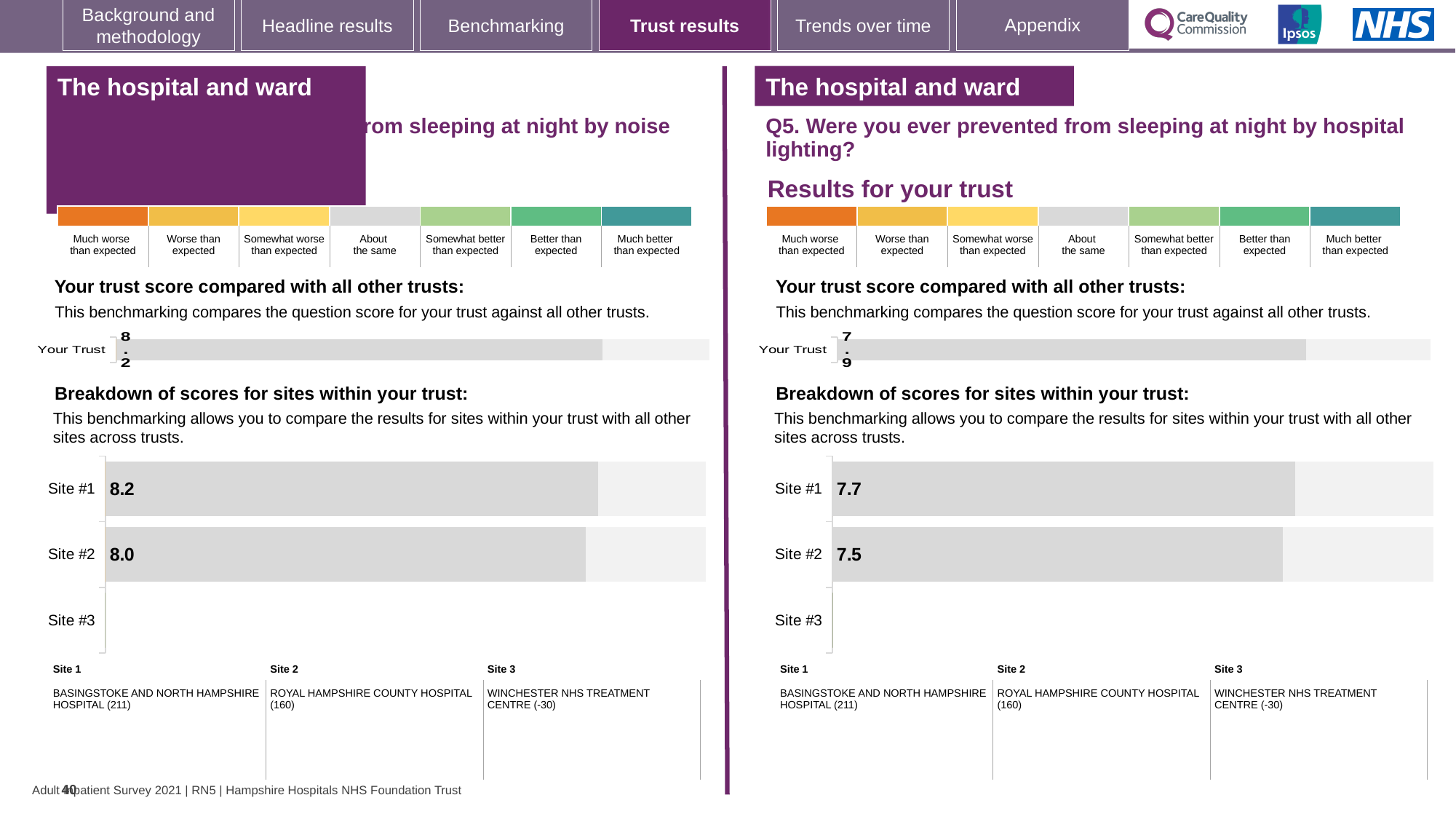
In the left-hand site breakdown chart (sleeping at night by noise), what is the score for Site #2? 8.0 How many site categories are listed on the axis of the left-hand site breakdown chart? 3 In the right-hand site breakdown chart for Q5 (hospital lighting), what is the score for Site #2? 7.5 In the left-hand site breakdown chart (sleeping at night by noise), what is the score for Site #1? 8.2 On the left-hand chart (sleeping at night by noise), what is the score shown for Your Trust? 8.2 In the right-hand site breakdown chart for Q5 (hospital lighting), what is the difference between the Site #1 and Site #2 scores? 0.2 In the right-hand site breakdown chart for Q5 (hospital lighting), which site has the higher score, Site #1 or Site #2? Site #1 In the left-hand site breakdown chart (sleeping at night by noise), what is the difference between the Site #1 and Site #2 scores? 0.2 Which site in the right-hand site breakdown chart for Q5 (hospital lighting) has no bar plotted? Site #3 On the right-hand chart for Q5 (hospital lighting), what is the score shown for Your Trust? 7.9 In the right-hand site breakdown chart for Q5 (hospital lighting), what is the score for Site #1? 7.7 What type of chart is used for the site breakdown on the right-hand side of the slide? Bar chart